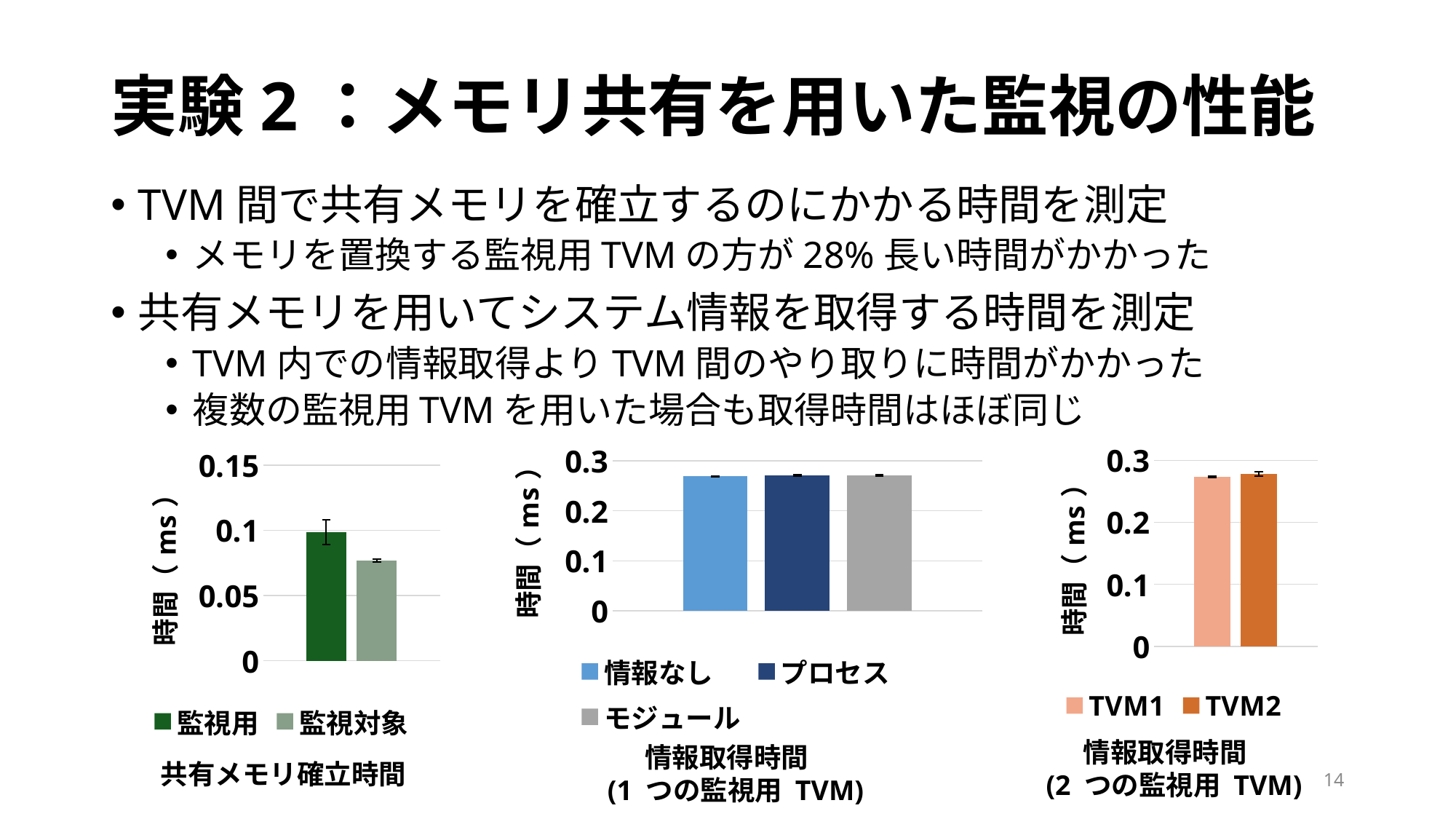
In the 共有メモリ確立時間 chart, which series has the higher value, 監視用 or 監視対象? 監視用 In the middle chart, 情報取得時間 (1 つの監視用 TVM), is the value for 情報なし greater or less than 0.3? less In the right chart, 情報取得時間 (2 つの監視用 TVM), is the value for TVM2 greater or less than 0.2? greater How many series does the legend of the 共有メモリ確立時間 chart list? 2 In the 共有メモリ確立時間 chart, is the value for 監視用 greater or less than 0.05? greater What is the y-axis label of the middle chart, 情報取得時間 (1 つの監視用 TVM)? 時間（ms） What kind of chart is the 共有メモリ確立時間 chart on the left? bar chart How many series does the legend of the right chart, 情報取得時間 (2 つの監視用 TVM), list? 2 How many series does the legend of the middle chart, 情報取得時間 (1 つの監視用 TVM), list? 3 In the 共有メモリ確立時間 chart, which series has the highest value? 監視用